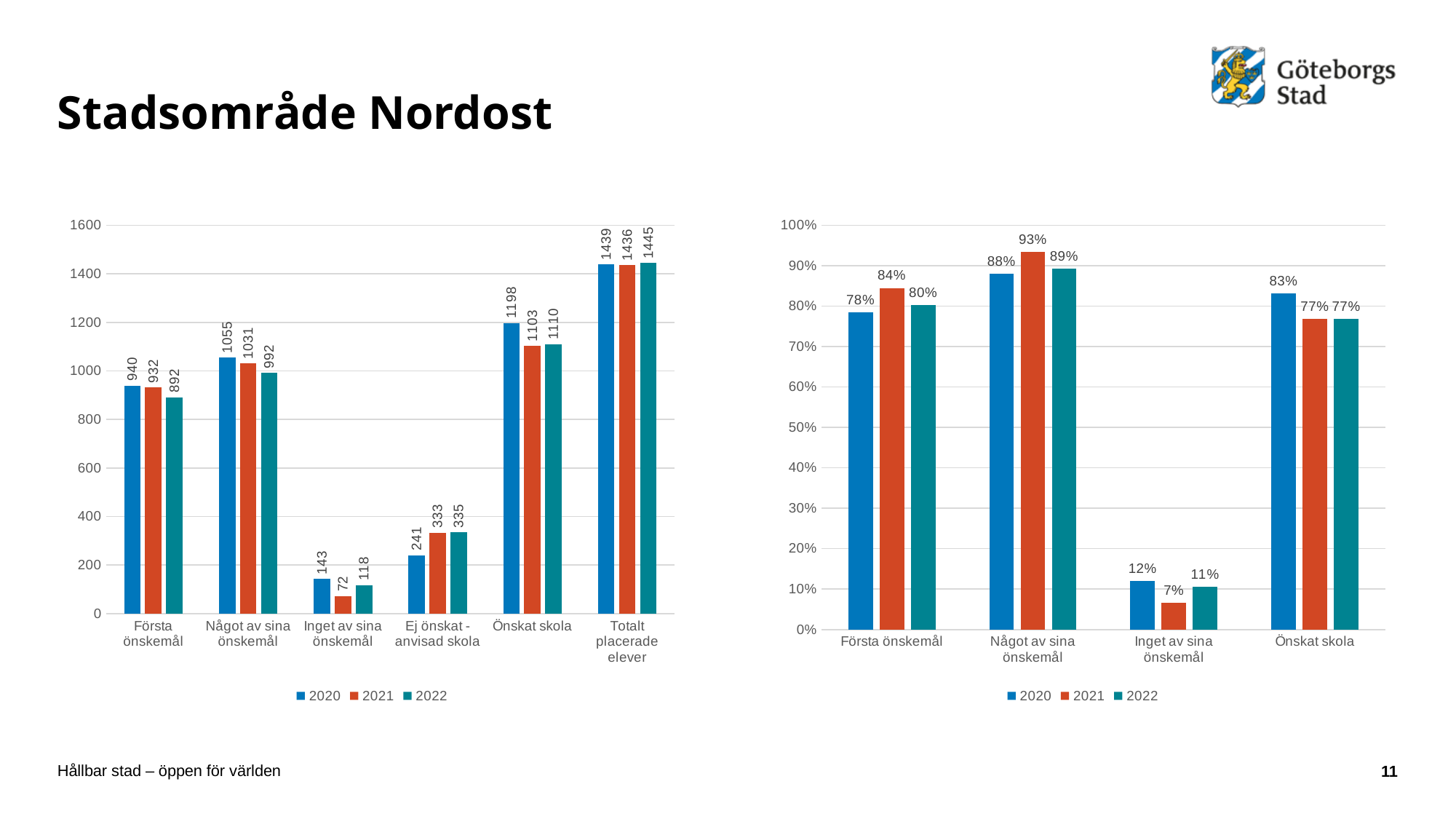
How many series does the legend of the right chart list? 3 In the left chart, how many categories are shown on the x axis? 6 In the right chart, what is the value for 2020 in the 'Önskat skola' category? 83% In the left chart, what is the value for 2020 in the 'Första önskemål' category? 940 In the left chart, which category has the lowest value for 2021? Inget av sina önskemål In the left chart, what is the value for 2022 in the 'Totalt placerade elever' category? 1445 In the left chart, do the values for 'Första önskemål' rise or fall from 2020 to 2022? fall In the right chart, which is larger for 'Första önskemål': the 2020 value or the 2021 value? 2021 In the left chart, what is the value for 2021 in the 'Inget av sina önskemål' category? 72 In the right chart, which category has the highest value for 2022? Något av sina önskemål In the left chart, what is the difference between the 2020 and 2022 values for 'Önskat skola'? 88 In the right chart, what is the value for 2021 in the 'Något av sina önskemål' category? 93%